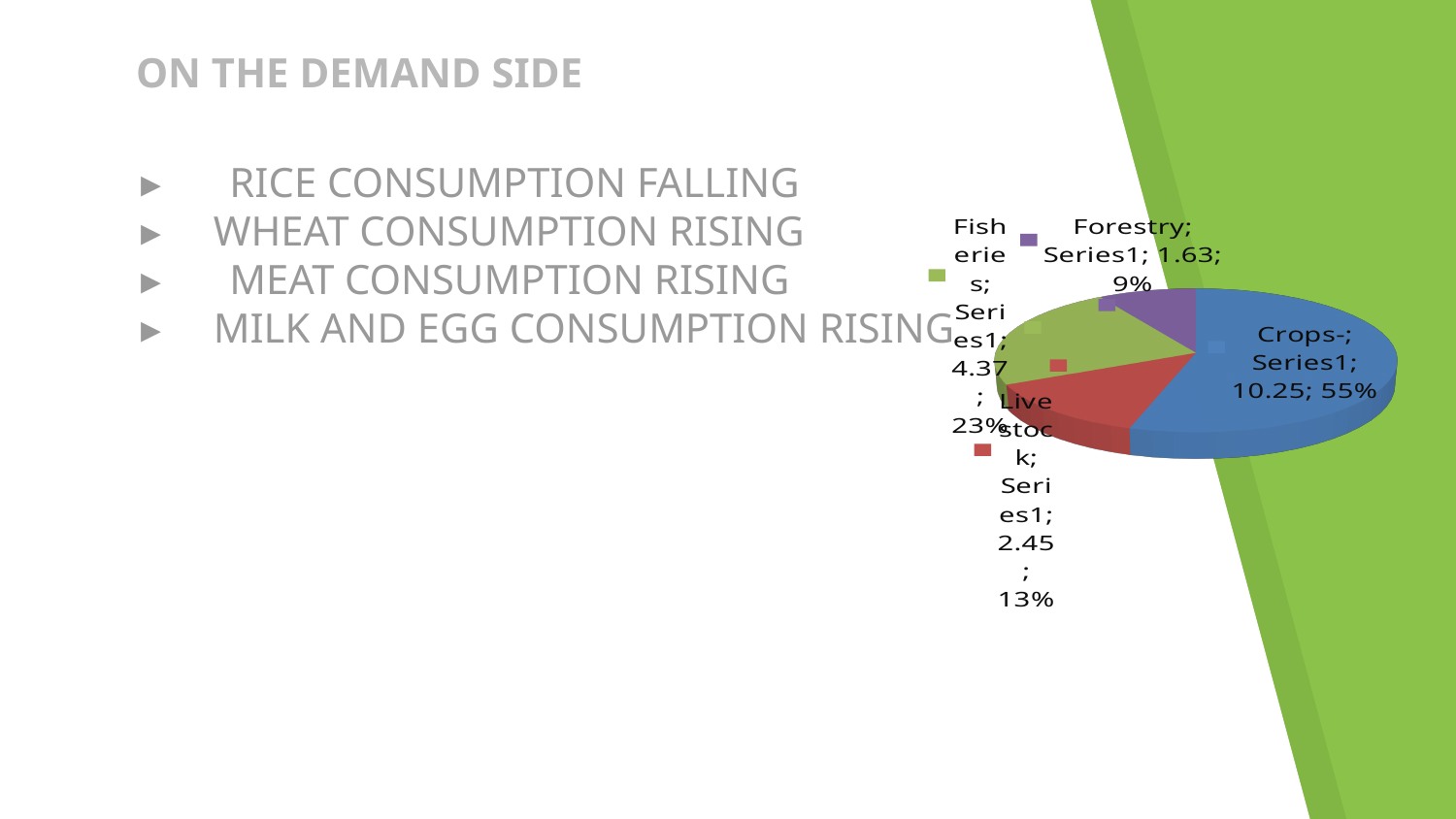
Which category has the smallest slice in the pie chart? Forestry Which is larger in the pie chart, Livestock or Fisheries? Fisheries How many slices does the pie chart have? 4 What is the value for Crops in the pie chart? 10.25 What is the difference between the values for Crops and Fisheries in the pie chart? 5.88 What is the value for Livestock in the pie chart? 2.45 What is the value for Fisheries in the pie chart? 4.37 Which category has the largest slice in the pie chart? Crops What percentage share does Fisheries have in the pie chart? 23% What percentage share does Crops have in the pie chart? 55% What kind of chart is shown on the slide? pie chart What percentage share does Forestry have in the pie chart? 9%